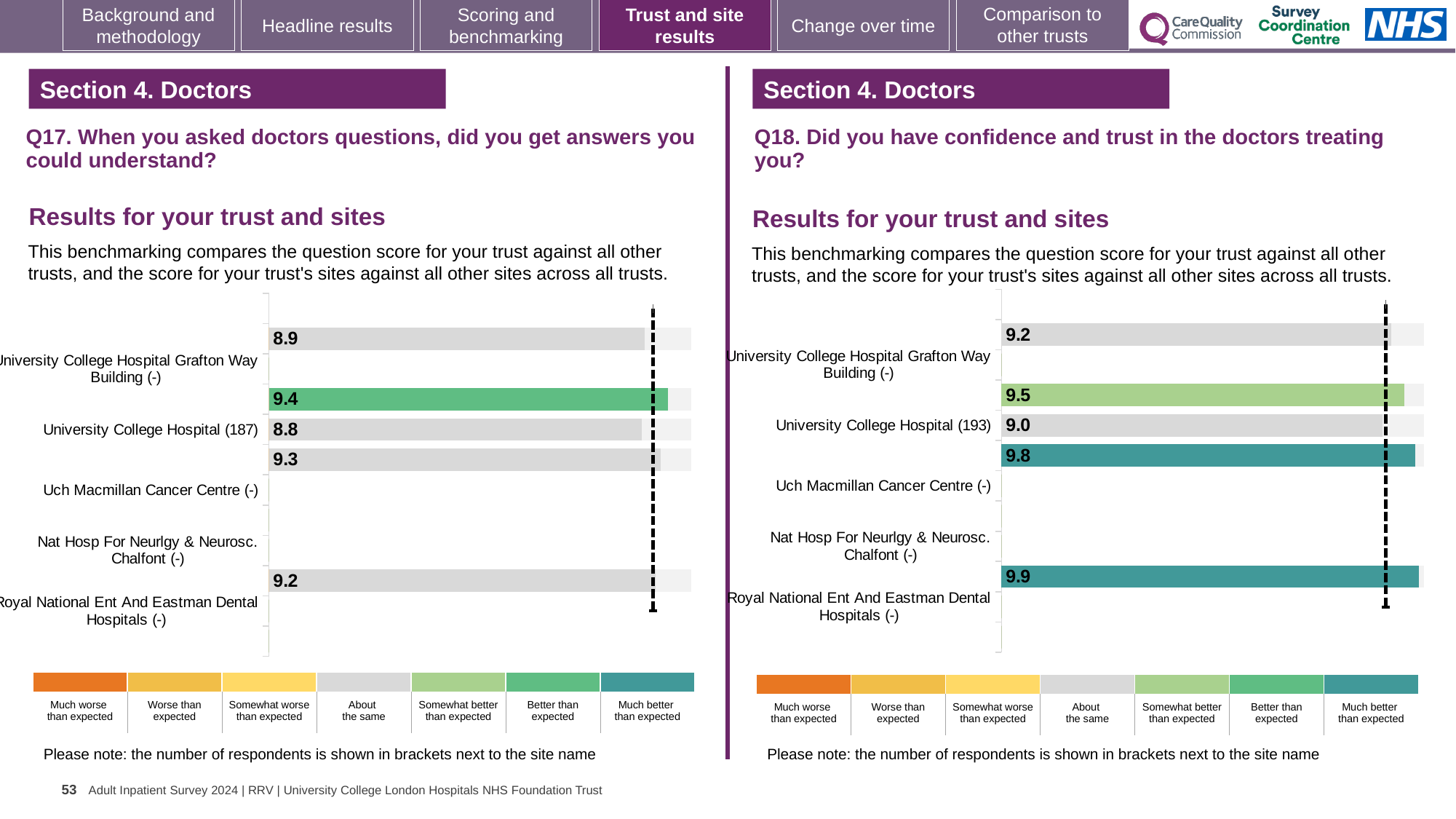
What kind of chart is used on the Q17 (left) side of the slide? Bar chart On the Q18 chart (right), how many respondents are shown in brackets for University College Hospital? 193 On the Q18 chart (right), which is larger: the top bar score of 9.2 or the bottom bar score of 9.9? 9.9 On the Q17 chart (left), what is the score shown for University College Hospital (187)? 8.8 On the Q17 chart (left), which benchmark category does the colour of the 9.4 bar correspond to in the key? Better than expected How many benchmark categories does the colour key below each chart list? 7 On the Q17 chart (left), what is the lowest score shown on any bar? 8.8 On the Q17 chart (left), what is the highest score shown on any bar? 9.4 On the Q18 chart (right), what is the score shown for University College Hospital (193)? 9.0 On the Q17 chart (left), what is the difference between the highest bar score (9.4) and the score for University College Hospital (187)? 0.6 On the Q18 chart (right), what is the highest score shown on any bar? 9.9 On the Q18 chart (right), what is the lowest score shown on any bar? 9.0